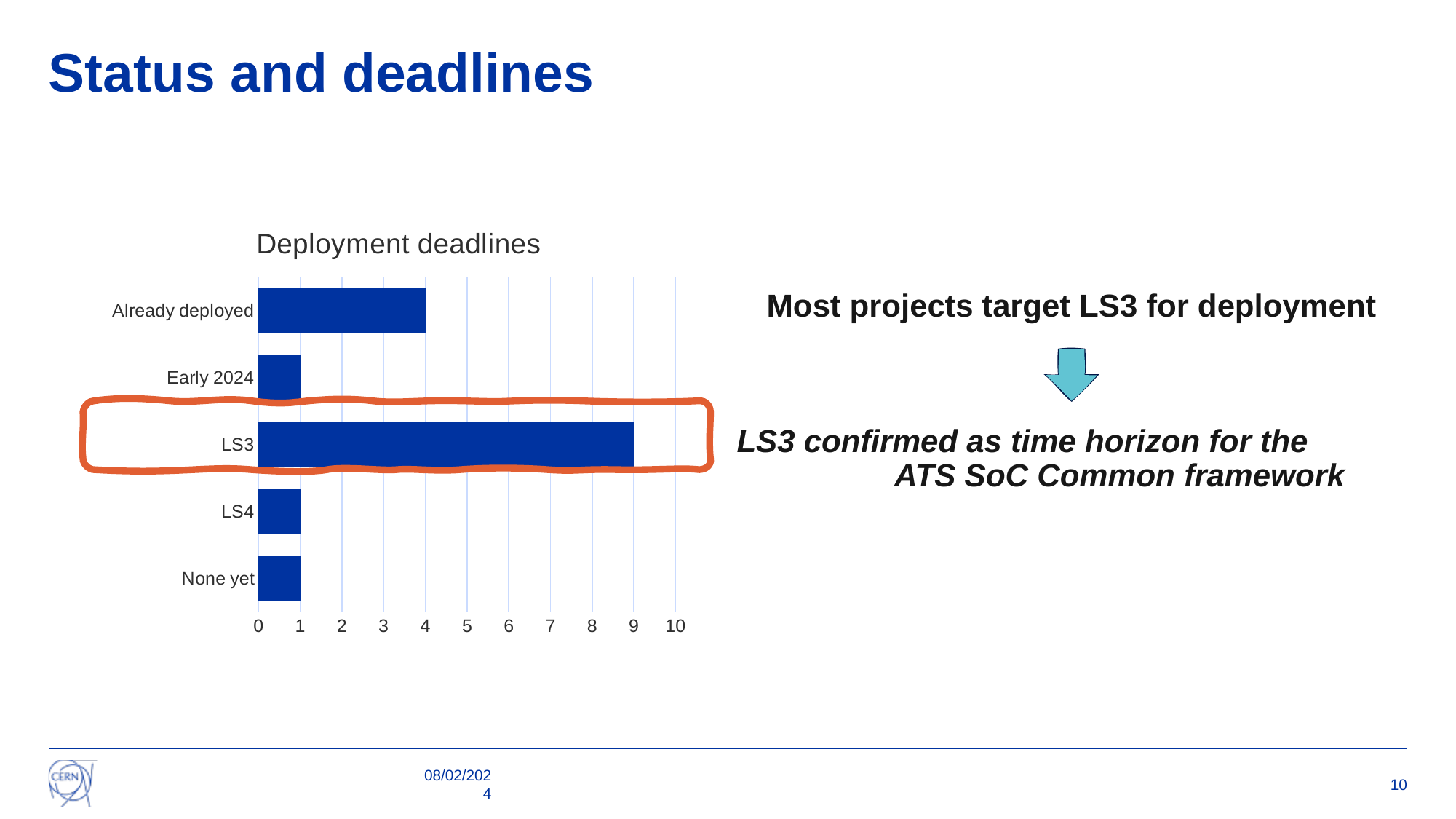
What is the title of the chart? Deployment deadlines Which is larger, the value for Already deployed or the value for LS4? Already deployed What is the difference between the values for LS3 and Already deployed? 5 Which category has the highest value? LS3 What is the highest value shown on the x axis? 10 What kind of chart is shown on the slide? bar chart What is the value for None yet? 1 What is the value for Early 2024? 1 What is the value for LS3? 9 Is the value for LS3 greater or less than 5? greater What is the value for Already deployed? 4 How many categories does the chart show? 5